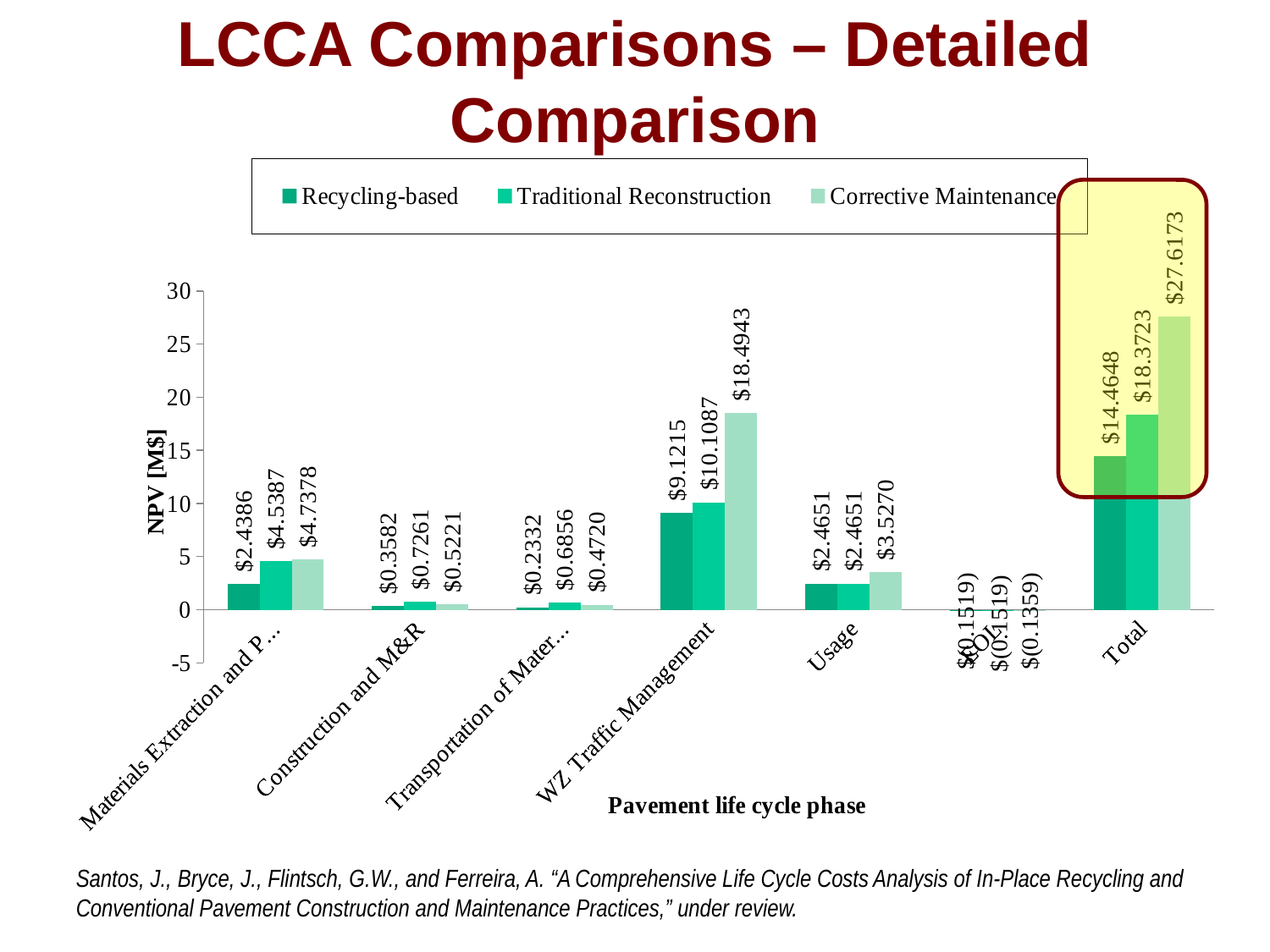
What is the Total NPV for the Corrective Maintenance series? $27.6173 What is the label of the y axis? NPV [M$] What is the NPV for Corrective Maintenance in the Usage phase? $3.5270 What is the NPV for Recycling-based in the WZ Traffic Management phase? $9.1215 How many series does the legend list? 3 Excluding Total, which life cycle phase has the lowest NPV for the Recycling-based series? EOL What is the difference between the Corrective Maintenance and Recycling-based Total NPV values? $13.1525 In the Construction and M&R phase, which is larger: Traditional Reconstruction or Corrective Maintenance? Traditional Reconstruction How many pavement life cycle phase categories are shown on the x axis, including Total? 7 Which series has the highest Total NPV? Corrective Maintenance What is the NPV for Traditional Reconstruction in the Construction and M&R phase? $0.7261 What type of chart is shown on the slide? bar chart